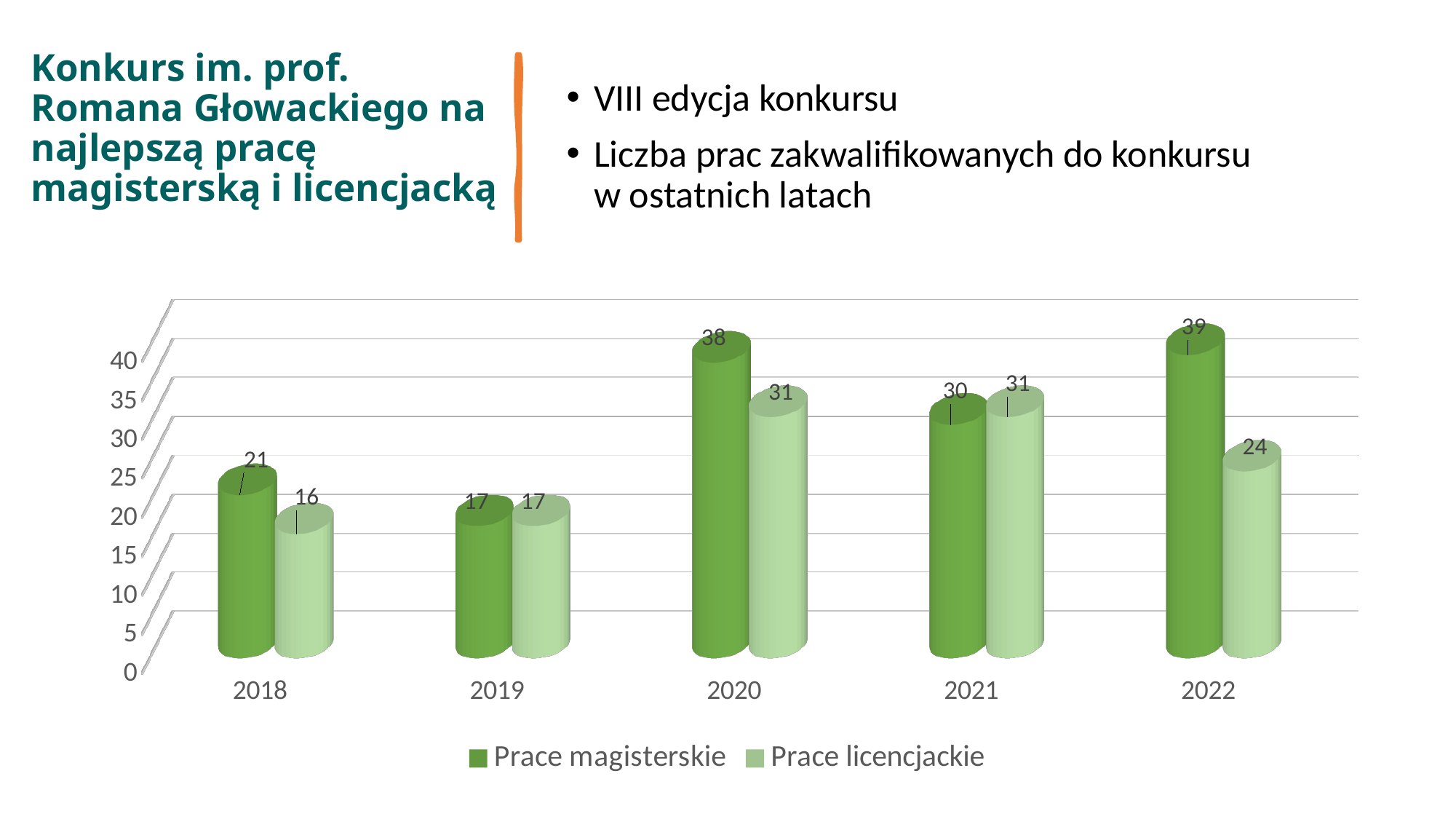
What are the two legend entries of the chart? Prace magisterskie, Prace licencjackie Which year has the highest value for Prace magisterskie? 2022 What is the value for Prace licencjackie in 2022? 24 In 2021, which series has the larger value, Prace magisterskie or Prace licencjackie? Prace licencjackie How many series does the legend list? 2 How many years are shown on the x axis? 5 What is the difference between Prace magisterskie and Prace licencjackie in 2022? 15 What kind of chart is shown on the slide? bar chart Which year has the lowest value for Prace licencjackie? 2018 What is the value for Prace magisterskie in 2020? 38 What is the total of Prace magisterskie and Prace licencjackie in 2019? 34 What is the value for Prace licencjackie in 2018? 16